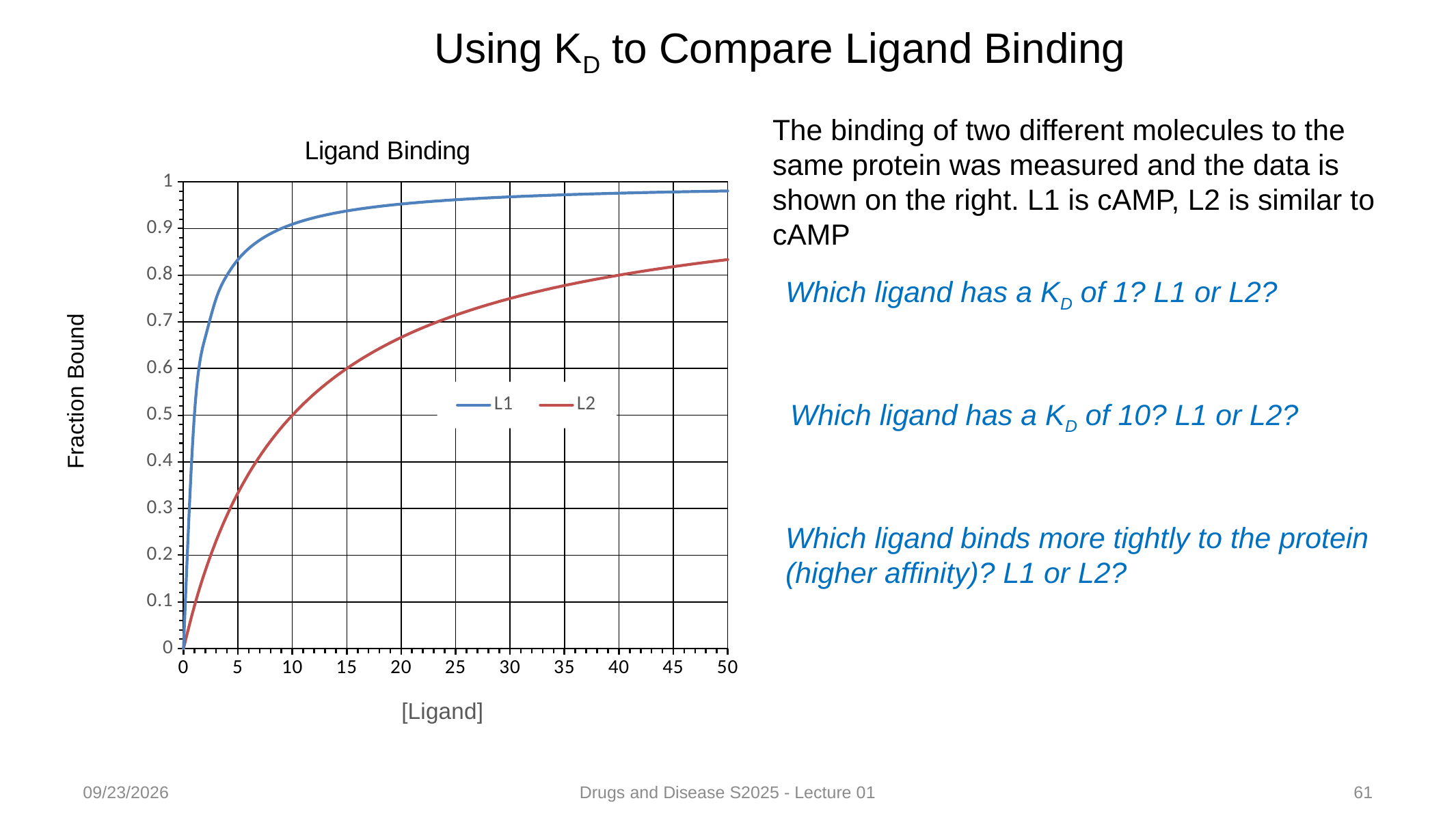
What is the label of the y axis of the chart? Fraction Bound Does the Fraction Bound for L2 rise or fall as [Ligand] increases from 0 to 50? rise At a [Ligand] of 10, which series has the higher Fraction Bound, L1 or L2? L1 At a [Ligand] of 25, which series has the lower Fraction Bound, L1 or L2? L2 What is the title of the chart? Ligand Binding Is the Fraction Bound for L1 at a [Ligand] of 20 greater or less than 0.9? greater How many series does the legend of the Ligand Binding chart list? 2 Is the Fraction Bound for L2 at a [Ligand] of 30 greater or less than 0.7? greater Which series reaches a Fraction Bound of 0.9 at a lower [Ligand], L1 or L2? L1 Is the Fraction Bound for L2 at a [Ligand] of 50 greater or less than 0.8? greater What kind of chart is shown on the slide? line chart